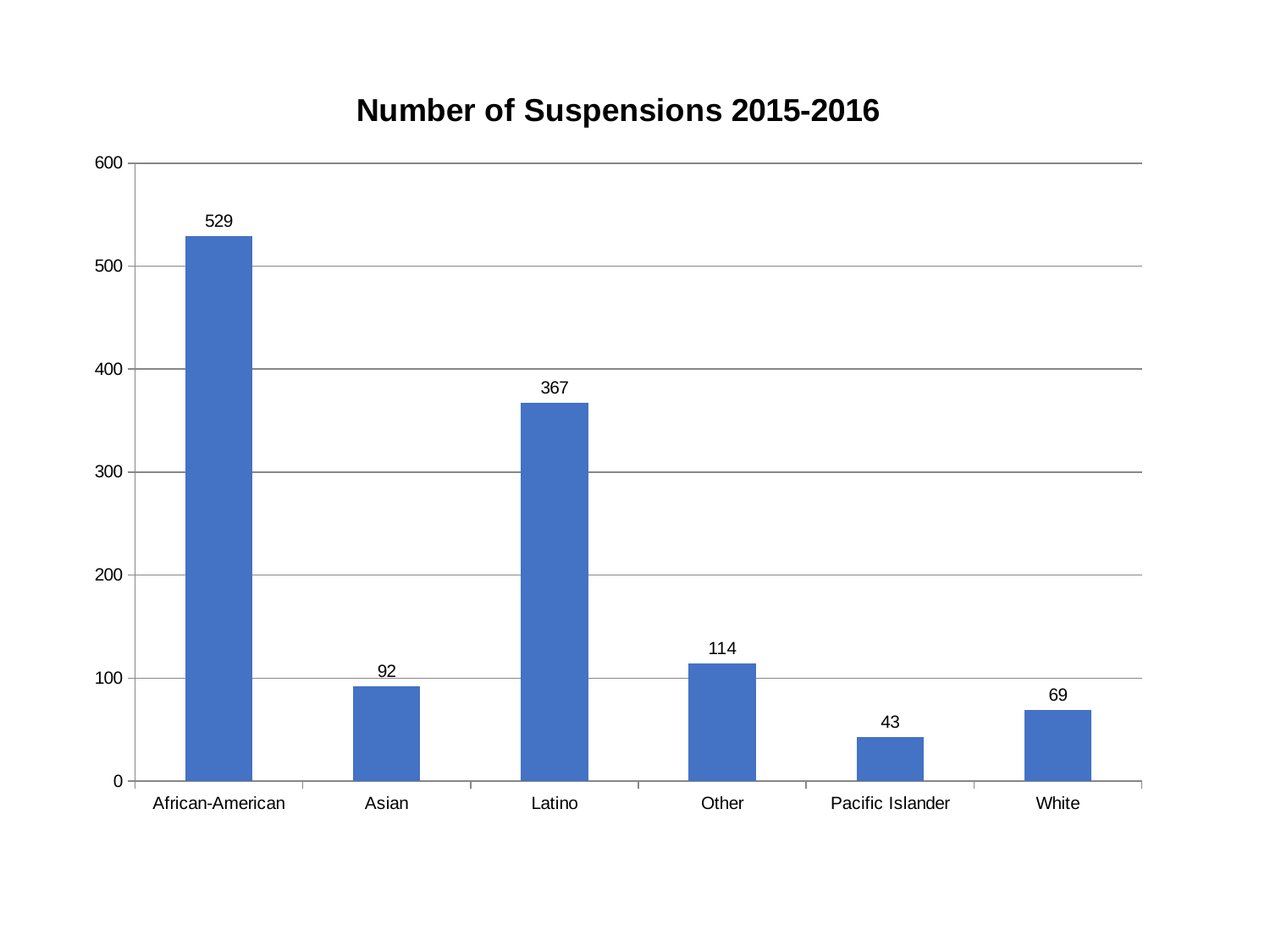
What is the difference in suspensions between African-American and Latino students? 162 What is the number of suspensions for African-American students? 529 Which category has the lowest number of suspensions? Pacific Islander What is the number of suspensions for Latino students? 367 What is the number of suspensions for Pacific Islander students? 43 What is the difference in suspensions between Other and Asian? 22 What is the number of suspensions for White students? 69 What type of chart is shown on the slide? Bar chart How many categories are shown on the x axis? 6 Which category has the highest number of suspensions? African-American Is the value for Other greater or less than 100? greater Which has more suspensions, Asian or White? Asian